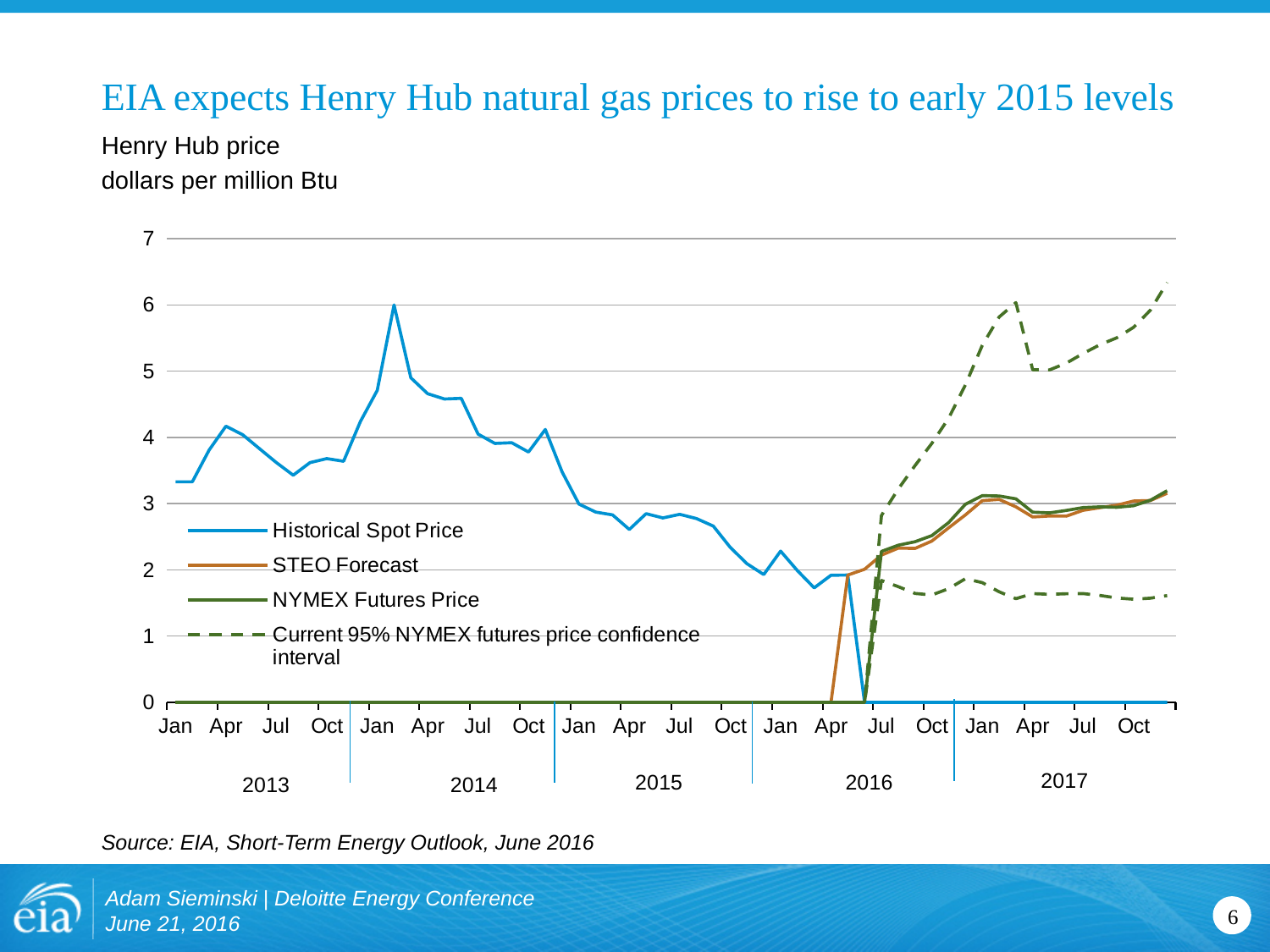
What unit is the Henry Hub price plotted in, according to the chart subtitle? dollars per million Btu Which series is drawn with a dashed line? Current 95% NYMEX futures price confidence interval How many series does the legend list? 4 Is the upper bound of the 95% NYMEX futures price confidence interval at the end of 2017 greater or less than 5? greater In which year does the Historical Spot Price reach its highest peak? 2014 Does the Historical Spot Price generally rise or fall over the course of 2015? fall Is the peak of the Historical Spot Price in early 2014 greater or less than 5? greater Does the STEO Forecast generally rise or fall from mid-2016 to the end of 2017? rise Is the lower bound of the 95% NYMEX futures price confidence interval at the end of 2017 greater or less than 2? less What kind of chart is shown on the slide? line chart